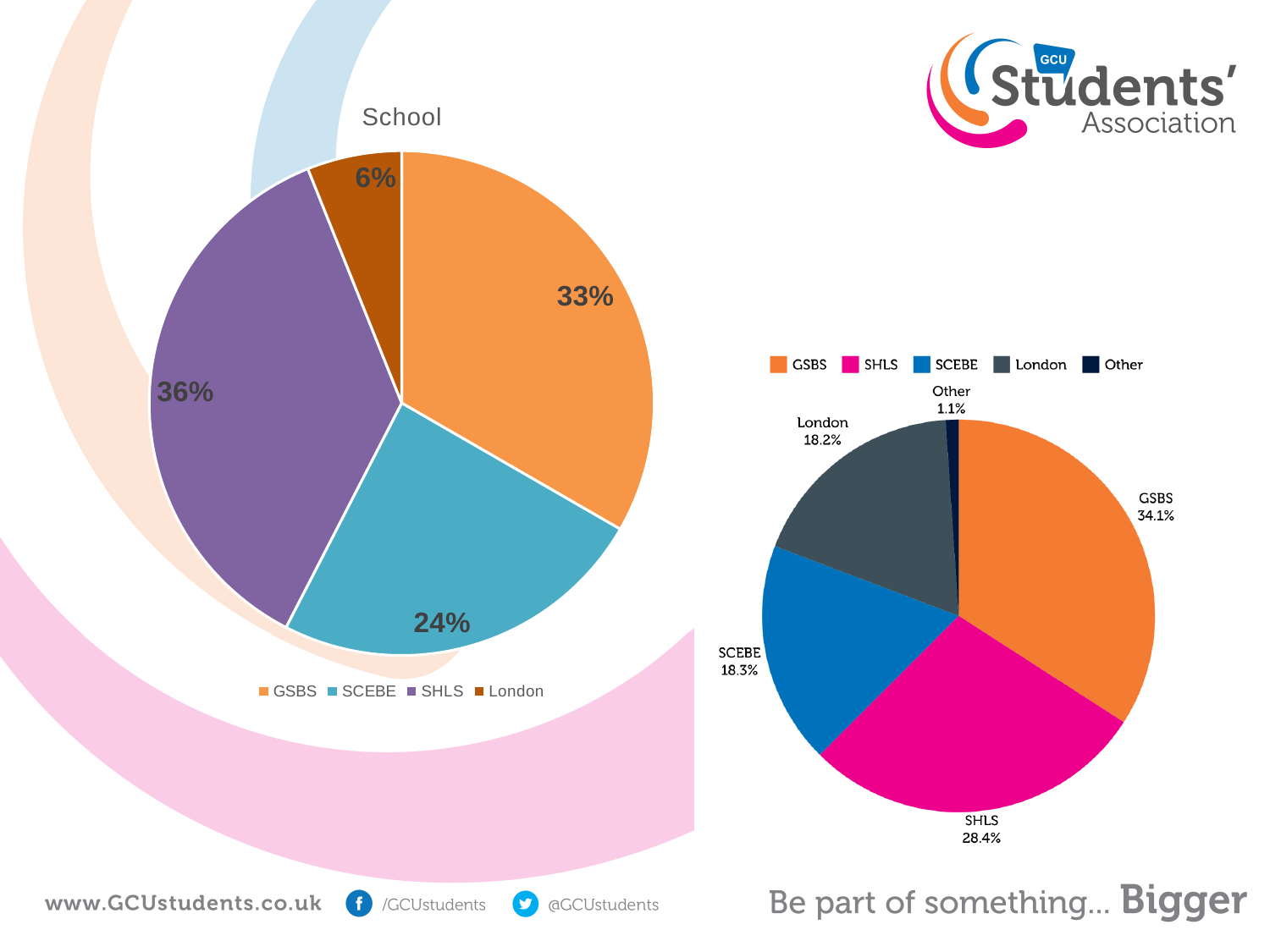
In the pie chart on the right of the slide, which is larger, the share for SHLS or the share for SCEBE? SHLS In the pie chart titled "School" on the left, how many slices does the pie have? 4 In the pie chart titled "School" on the left, what share does London have? 6% In the pie chart titled "School" on the left, what is the difference between the GSBS share and the SCEBE share? 9% What kind of chart is the chart on the right of the slide? Pie chart In the pie chart titled "School" on the left, what share does SHLS have? 36% In the pie chart titled "School" on the left, which school has the smallest share? London In the pie chart on the right of the slide, how many categories does the legend list? 5 In the pie chart on the right of the slide, what share does GSBS have? 34.1% In the pie chart on the right of the slide, what share does Other have? 1.1% In the pie chart titled "School" on the left, which school has the largest share? SHLS In the pie chart on the right of the slide, which category has the smallest share? Other